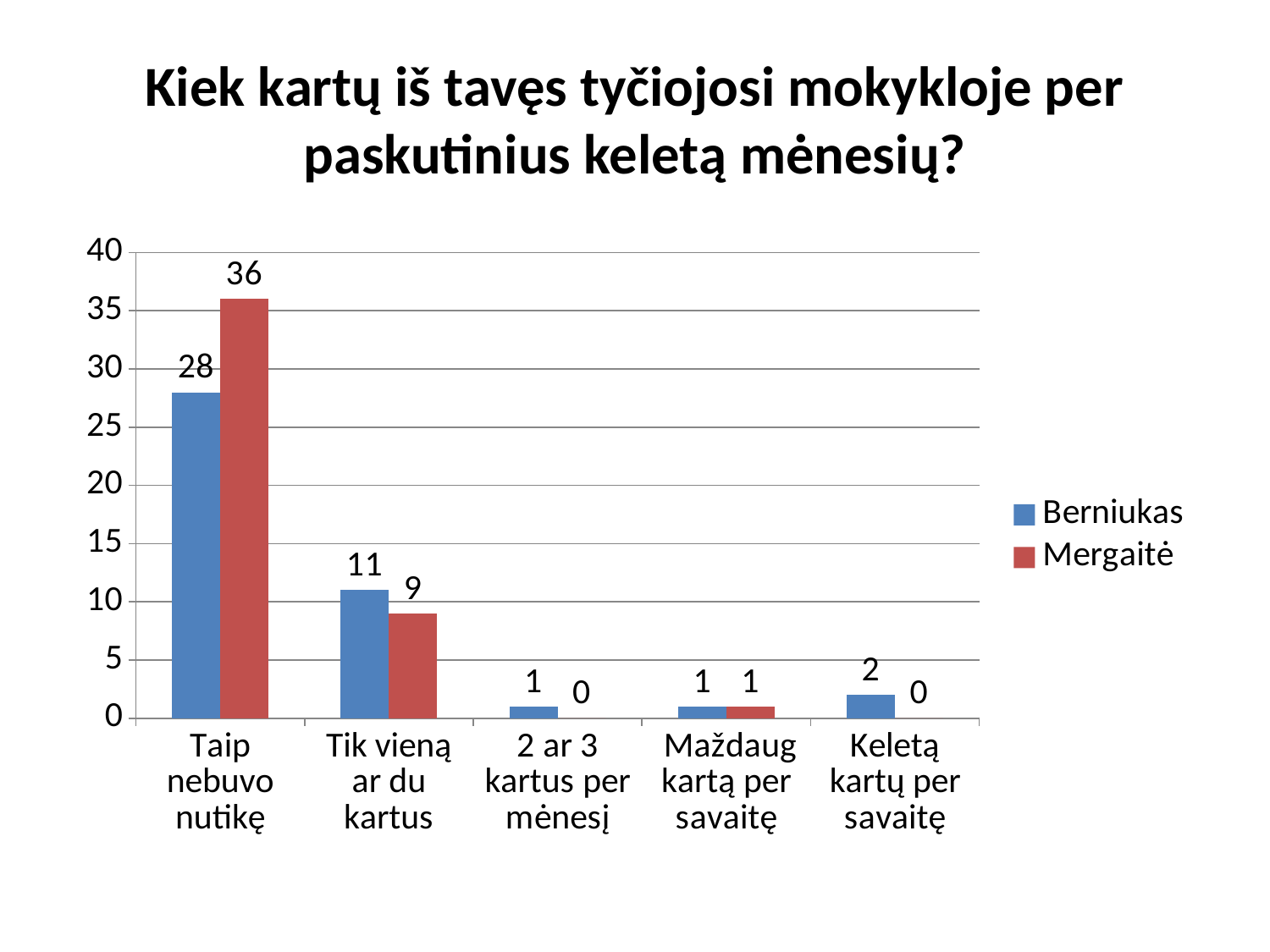
What is the value for Mergaitė in the "2 ar 3 kartus per mėnesį" category? 0 Is the value for Berniukas in the "Taip nebuvo nutikę" category greater or less than 25? greater How many categories are shown on the x axis? 5 Which colour represents the Mergaitė series in the legend? red In the "Tik vieną ar du kartus" category, which series has the larger value, Berniukas or Mergaitė? Berniukas What is the value for Berniukas in the "Tik vieną ar du kartus" category? 11 What is the value for Berniukas in the "Keletą kartų per savaitę" category? 2 Which category has the highest value for Berniukas? Taip nebuvo nutikę What kind of chart is shown on the slide? bar chart How many series does the legend list? 2 What is the value for Mergaitė in the "Taip nebuvo nutikę" category? 36 What is the difference between the Mergaitė and Berniukas values in the "Taip nebuvo nutikę" category? 8